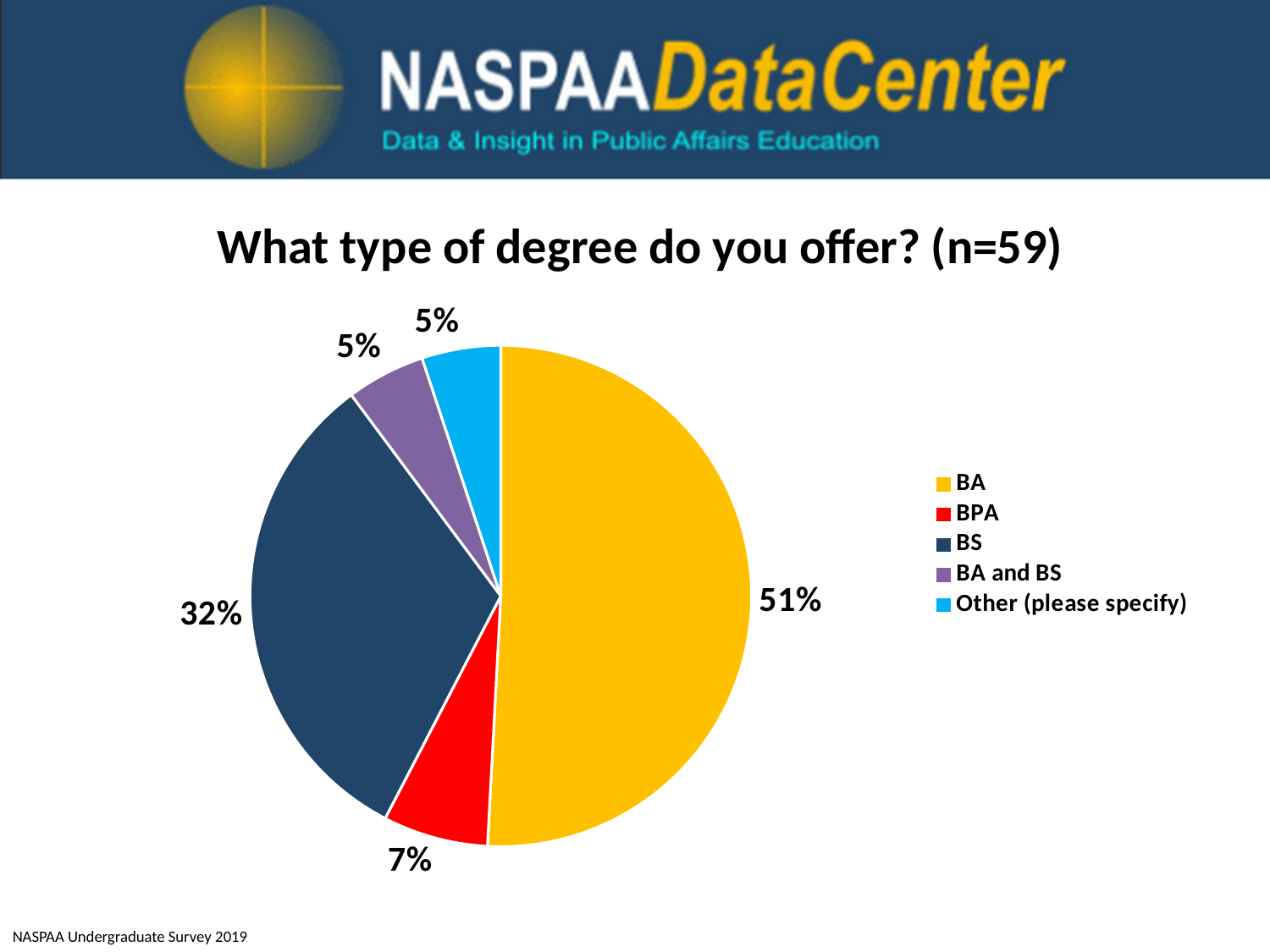
What percentage of respondents offer a BPA degree? 7% What is the title of the chart? What type of degree do you offer? (n=59) What percentage of respondents offer a BS degree? 32% What percentage of respondents offer a BA degree? 51% What percentage of respondents offer both a BA and BS? 5% What type of chart is shown on the slide? pie chart Which degree type has the largest share of the pie? BA What percentage of respondents chose 'Other (please specify)'? 5% Which is larger, the share for BS or the share for BPA? BS What colour is the BPA slice? red What is the difference in percentage points between the BA and BS slices? 19 How many categories does the legend list? 5